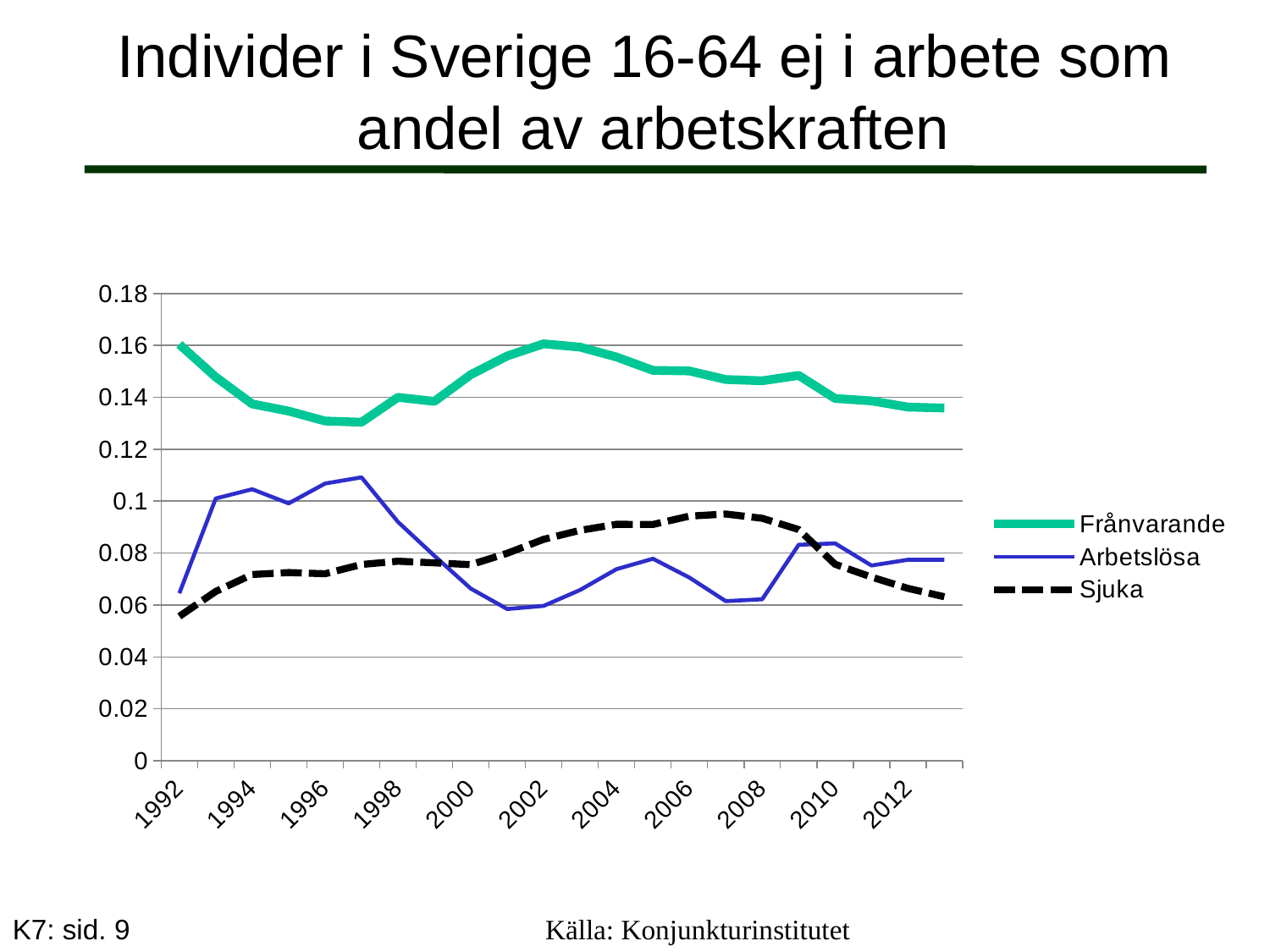
In 2006, which is higher: Sjuka or Arbetslösa? Sjuka Is the value for Sjuka in 2006 greater or less than 0.08? greater Which series has the highest values across the whole period? Frånvarande In 1996, which is higher: Arbetslösa or Sjuka? Arbetslösa Is the value for Arbetslösa in 1997 greater or less than 0.1? greater What kind of chart is shown on the slide? line chart Does the Frånvarande series rise or fall from 1992 to 1996? fall Which series is drawn with a dashed black line? Sjuka Does the Sjuka series rise or fall from 2006 to 2012? fall How many series does the legend list? 3 Is the value for Arbetslösa in 2002 greater or less than 0.08? less